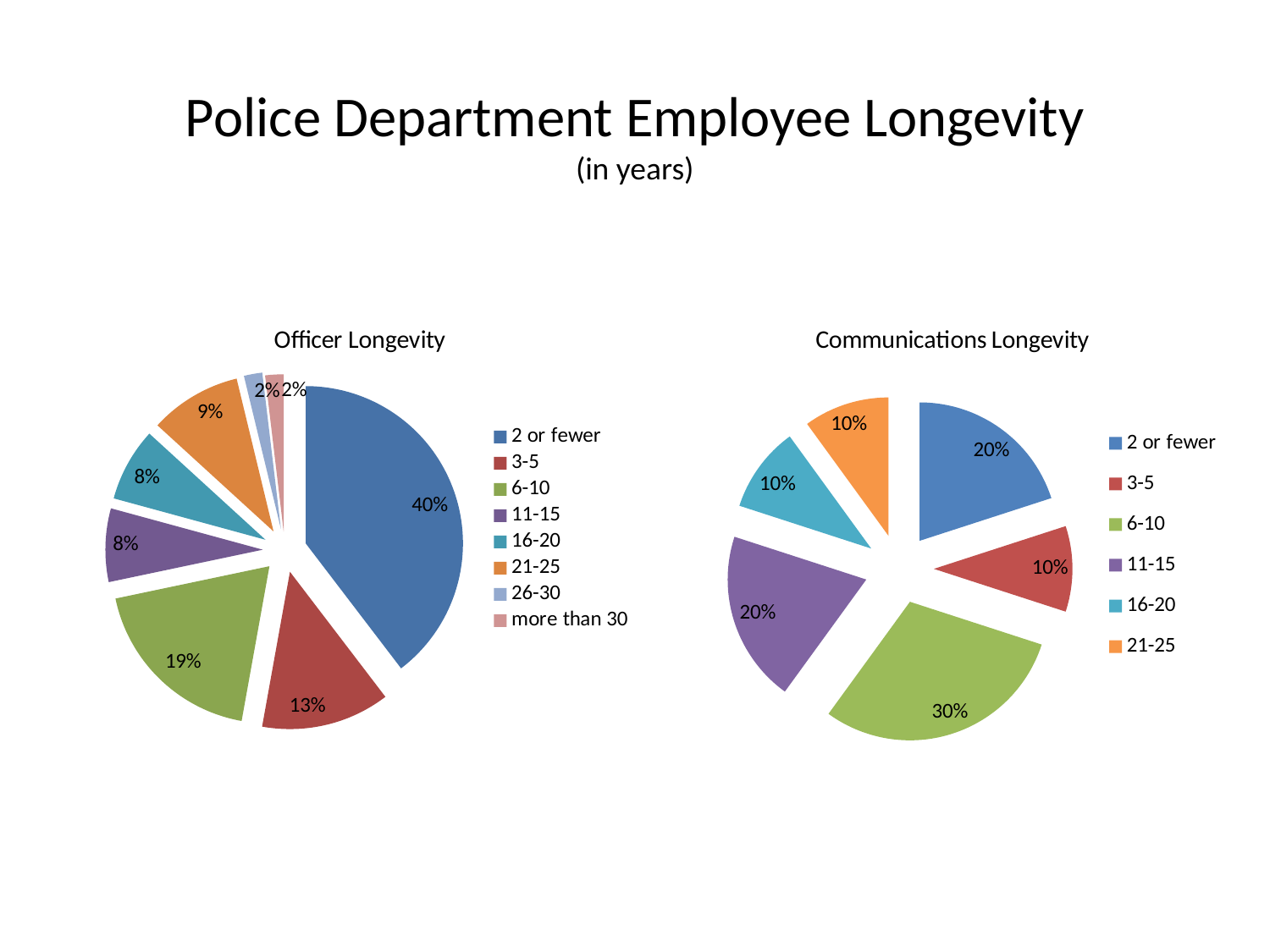
In the Communications Longevity chart, how many categories does the legend list? 6 In the Officer Longevity chart, which is larger, the 6-10 slice or the 3-5 slice? 6-10 In the Officer Longevity chart, which category has the largest slice? 2 or fewer What type of chart is the Communications Longevity chart? Pie chart In the Communications Longevity chart, what share of employees have 6-10 years? 30% In the Communications Longevity chart, which category has the largest slice? 6-10 In the Communications Longevity chart, what share of employees have 3-5 years? 10% In the Officer Longevity chart, what share of officers have 6-10 years? 19% In the Officer Longevity chart, what share of officers have 21-25 years? 9% In the Officer Longevity chart, what is the difference between the 2 or fewer slice and the 3-5 slice? 27% In the Officer Longevity chart, what share of officers have 2 or fewer years? 40% In the Officer Longevity chart, how many categories does the legend list? 8